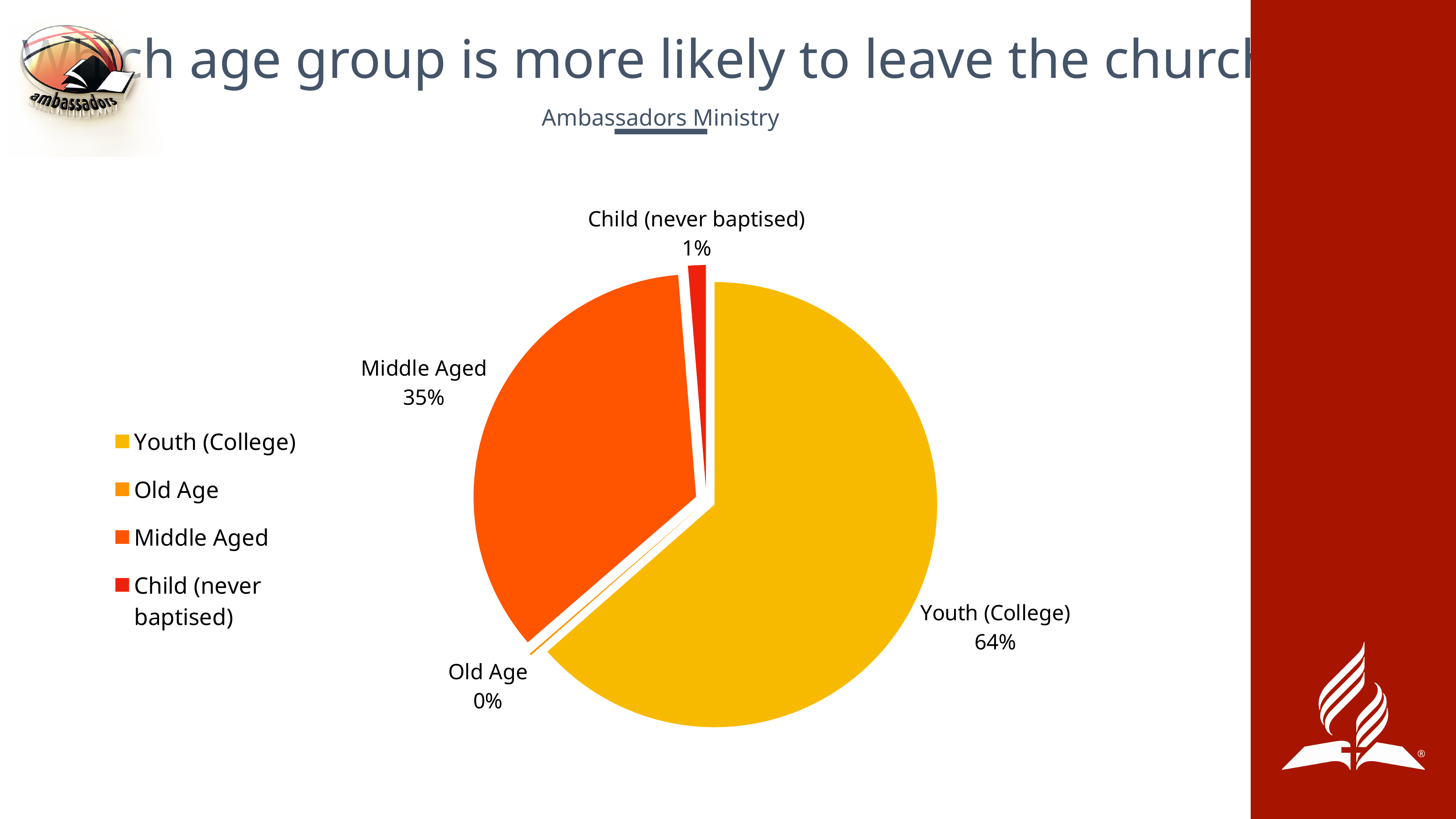
What kind of chart is shown on the slide? Pie chart Which legend entry is listed last? Child (never baptised) What share of the pie does Middle Aged represent? 35% What is the difference between the Youth (College) and Middle Aged percentages? 29% What colour is the Youth (College) slice? Yellow What is the value shown for Old Age? 0% Which is larger, the Middle Aged slice or the Child (never baptised) slice? Middle Aged What share of the pie does Youth (College) represent? 64% How many categories does the pie chart show? 4 What is the value shown for Child (never baptised)? 1% Which age group has the smallest slice of the pie? Old Age Which age group has the largest slice of the pie? Youth (College)